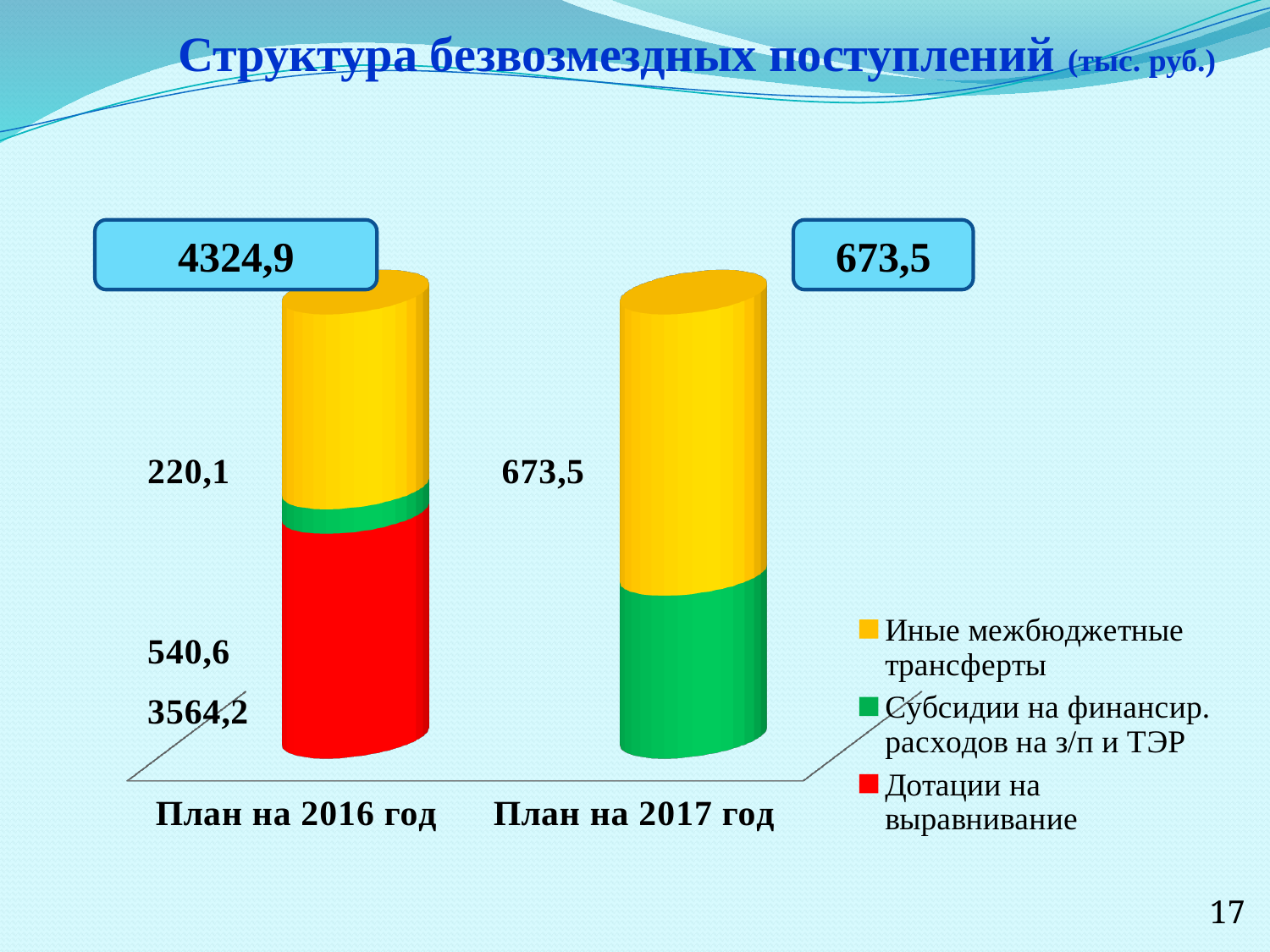
How many series does the legend list? 3 What colour represents Дотации на выравнивание in the legend? Red Do the bar totals rise or fall from План на 2016 год to План на 2017 год? Fall How many categories are shown on the x axis of the chart? 2 What is the difference between the totals for План на 2016 год and План на 2017 год? 3651,4 What kind of chart is shown on the slide? Stacked bar chart What is the total value shown for План на 2016 год? 4324,9 What is the title of the chart? Структура безвозмездных поступлений (тыс. руб.) What is the total value shown for План на 2017 год? 673,5 Which category has the lowest total? План на 2017 год Which category has the larger total, План на 2016 год or План на 2017 год? План на 2016 год